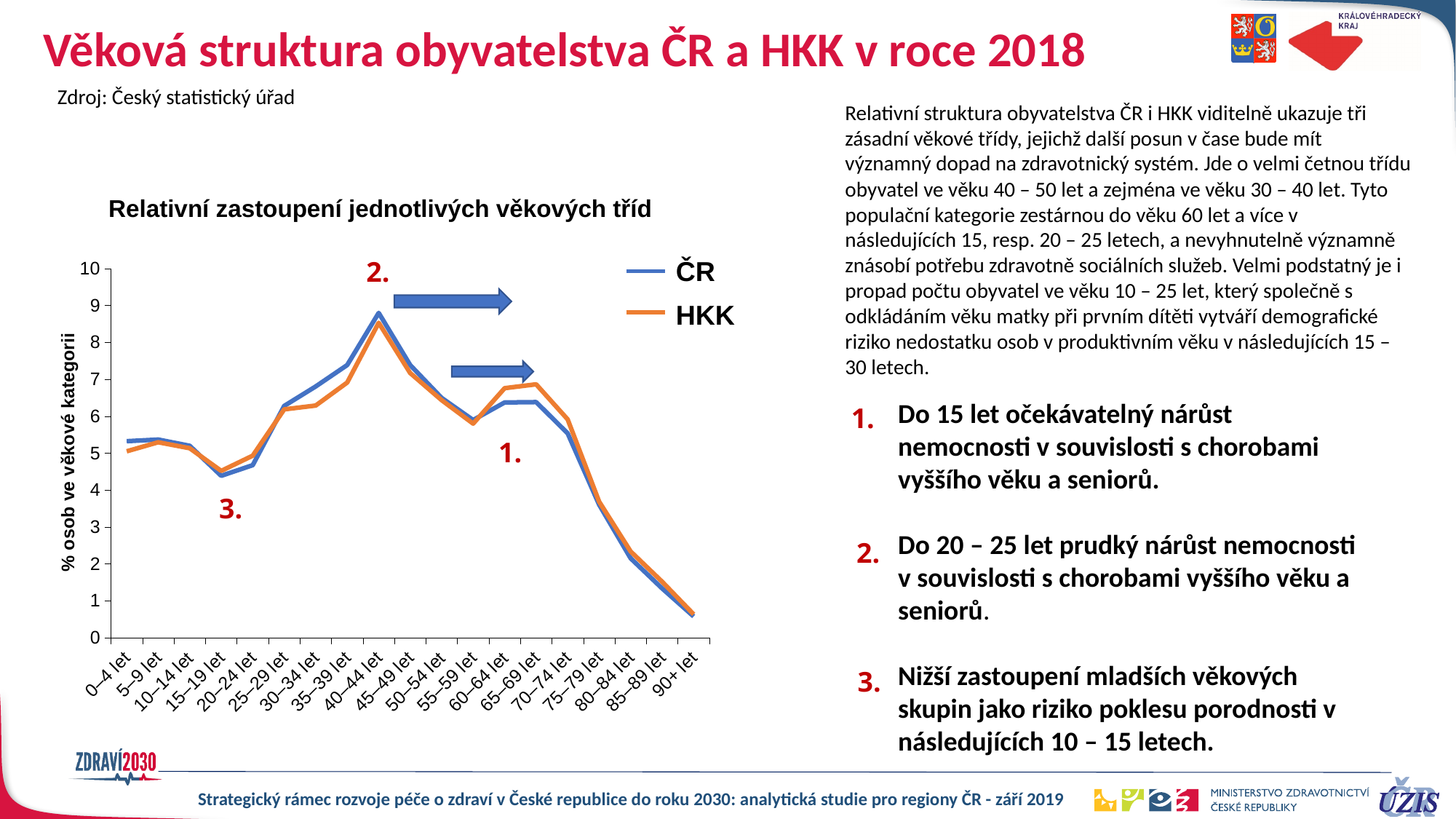
How many series does the legend list? 2 Which age category has the lowest value for the HKK series? 90+ let At 65–69 let, which series has the higher value, ČR or HKK? HKK Is the value for HKK at 15–19 let greater or less than 5? less How many age categories are plotted along the x axis? 19 Which age category has the highest value for the ČR series? 40–44 let What is the title of the chart? Relativní zastoupení jednotlivých věkových tříd Do the values for ČR rise or fall from 40–44 let to 90+ let? fall Is the value for ČR at 90+ let greater or less than 1? less What kind of chart is shown on the slide? line chart At 40–44 let, which series has the higher value, ČR or HKK? ČR Is the value for ČR at 40–44 let greater or less than 8? greater